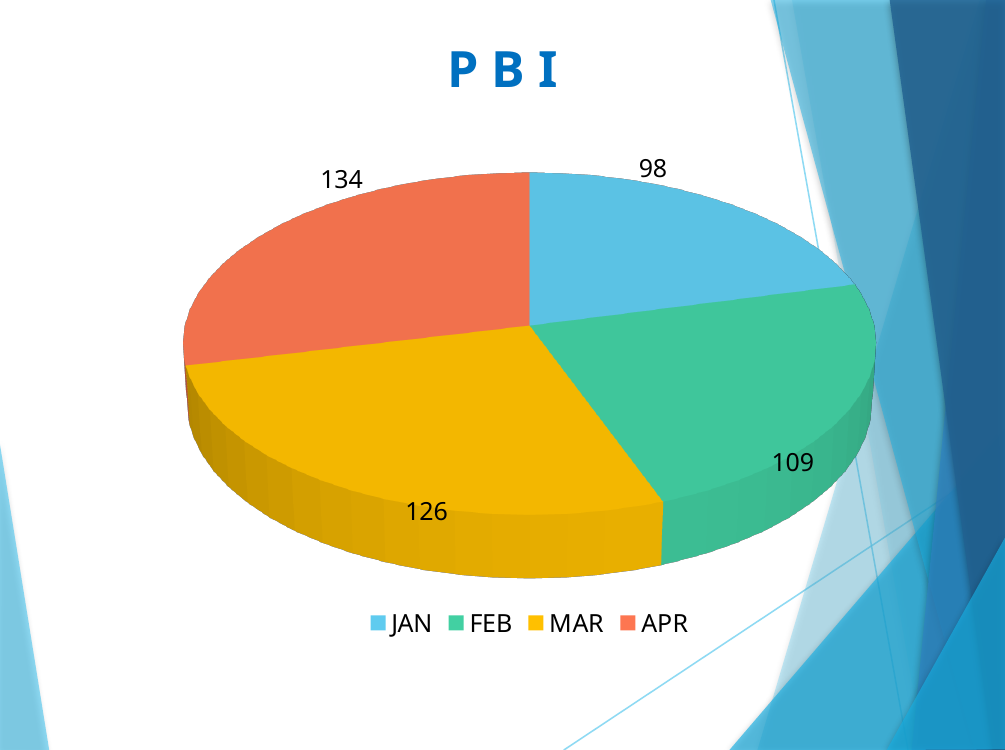
What is the title of the chart? P B I What is the difference between the values for MAR and FEB? 17 What is the total of all the slice values? 467 Which month has the smallest slice? JAN What is the value for APR? 134 Which month has the largest slice? APR Which is larger, the value for FEB or the value for MAR? MAR What is the value for JAN? 98 What is the value for MAR? 126 How many slices does the pie chart have? 4 What is the difference between the values for APR and JAN? 36 What kind of chart is shown on the slide? Pie chart